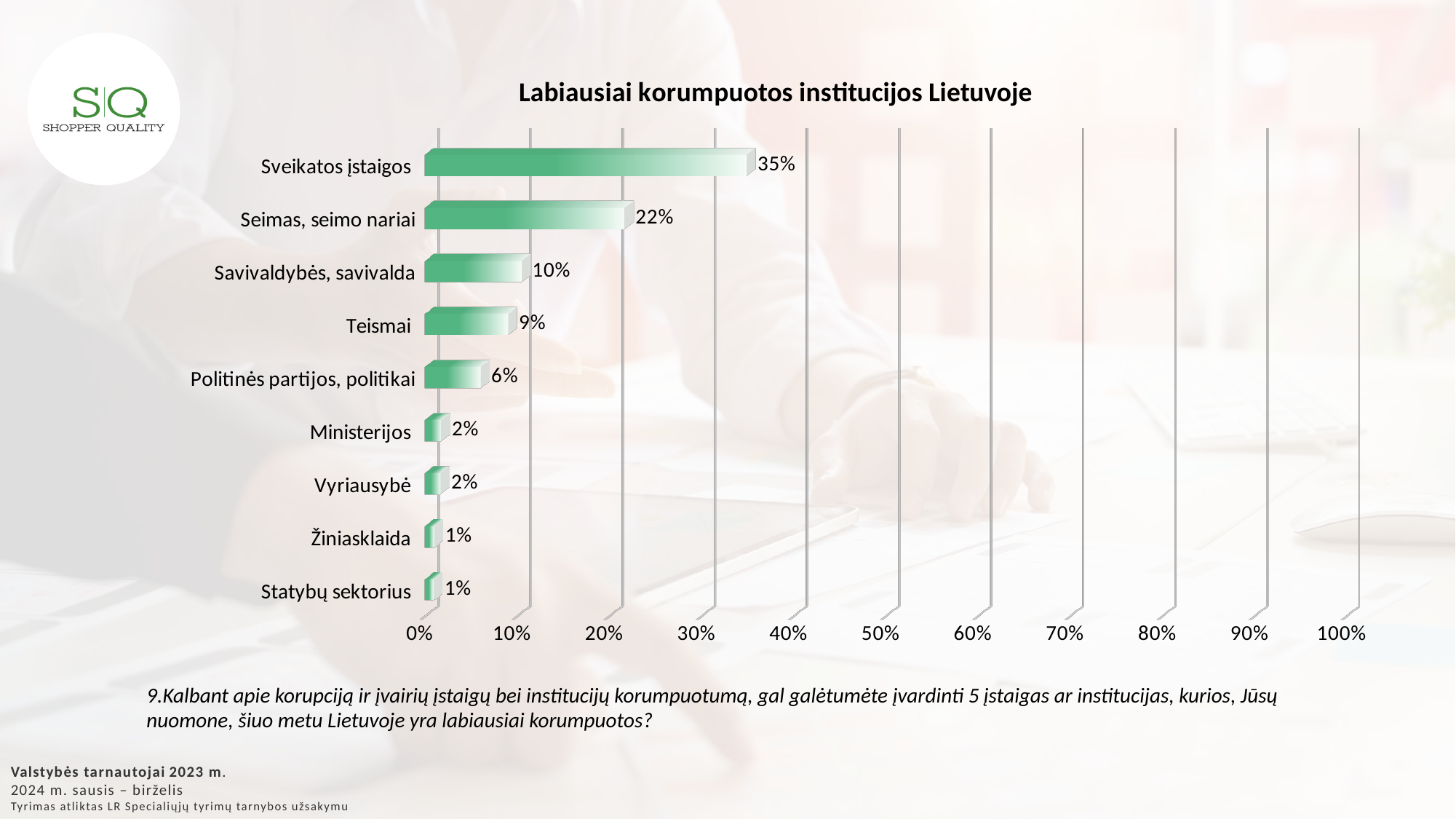
How many categories are shown in the chart? 9 What is the difference between the values for Sveikatos įstaigos and Seimas, seimo nariai? 13% What is the value for Teismai? 9% What kind of chart is shown on the slide? bar chart What is the value for Sveikatos įstaigos? 35% Is the value for Sveikatos įstaigos greater or less than 30%? greater What is the value for Politinės partijos, politikai? 6% What is the title of the chart? Labiausiai korumpuotos institucijos Lietuvoje What is the value for Seimas, seimo nariai? 22% What is the difference between the values for Savivaldybės, savivalda and Ministerijos? 8% Which category has the highest value? Sveikatos įstaigos Which is larger, the value for Savivaldybės, savivalda or the value for Teismai? Savivaldybės, savivalda